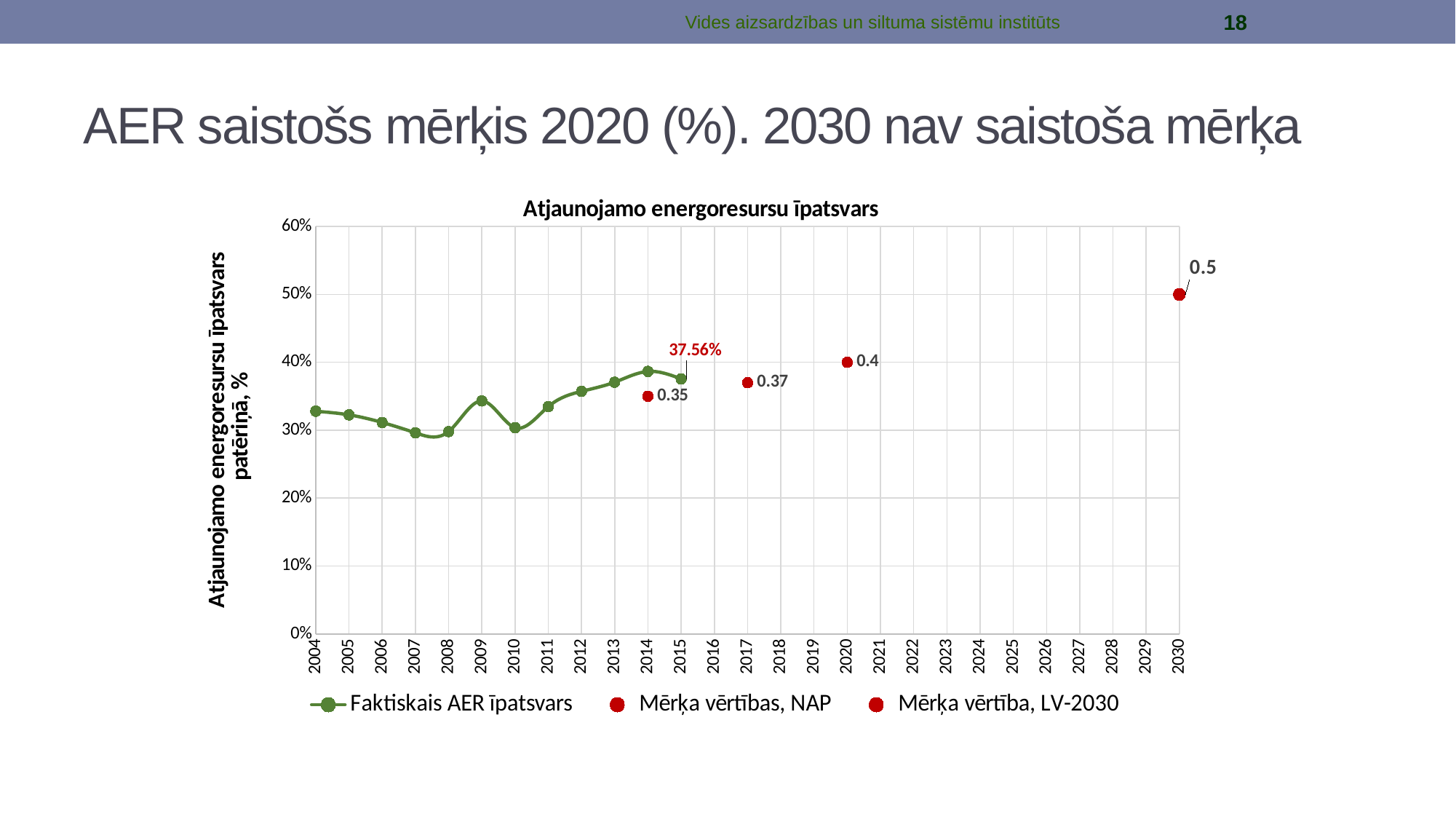
What is the NAP target value (Mērķa vērtības, NAP) shown for 2020? 0.4 What is the title of the chart? Atjaunojamo energoresursu īpatsvars What is the Mērķa vērtība, LV-2030 target value shown for 2030? 0.5 How many series does the legend list? 3 Which year has the higher Faktiskais AER īpatsvars value, 2009 or 2010? 2009 What is the NAP target value shown for 2017? 0.37 What is the labelled value of the Faktiskais AER īpatsvars series in 2015? 37.56% What is the NAP target value shown for 2014? 0.35 What kind of chart is shown on the slide? line chart Is the Faktiskais AER īpatsvars value for 2009 greater or less than 30%? greater Is the Faktiskais AER īpatsvars value for 2014 greater or less than 40%? less What is the difference between the 2030 target (0.5) and the 2020 target (0.4)? 0.1